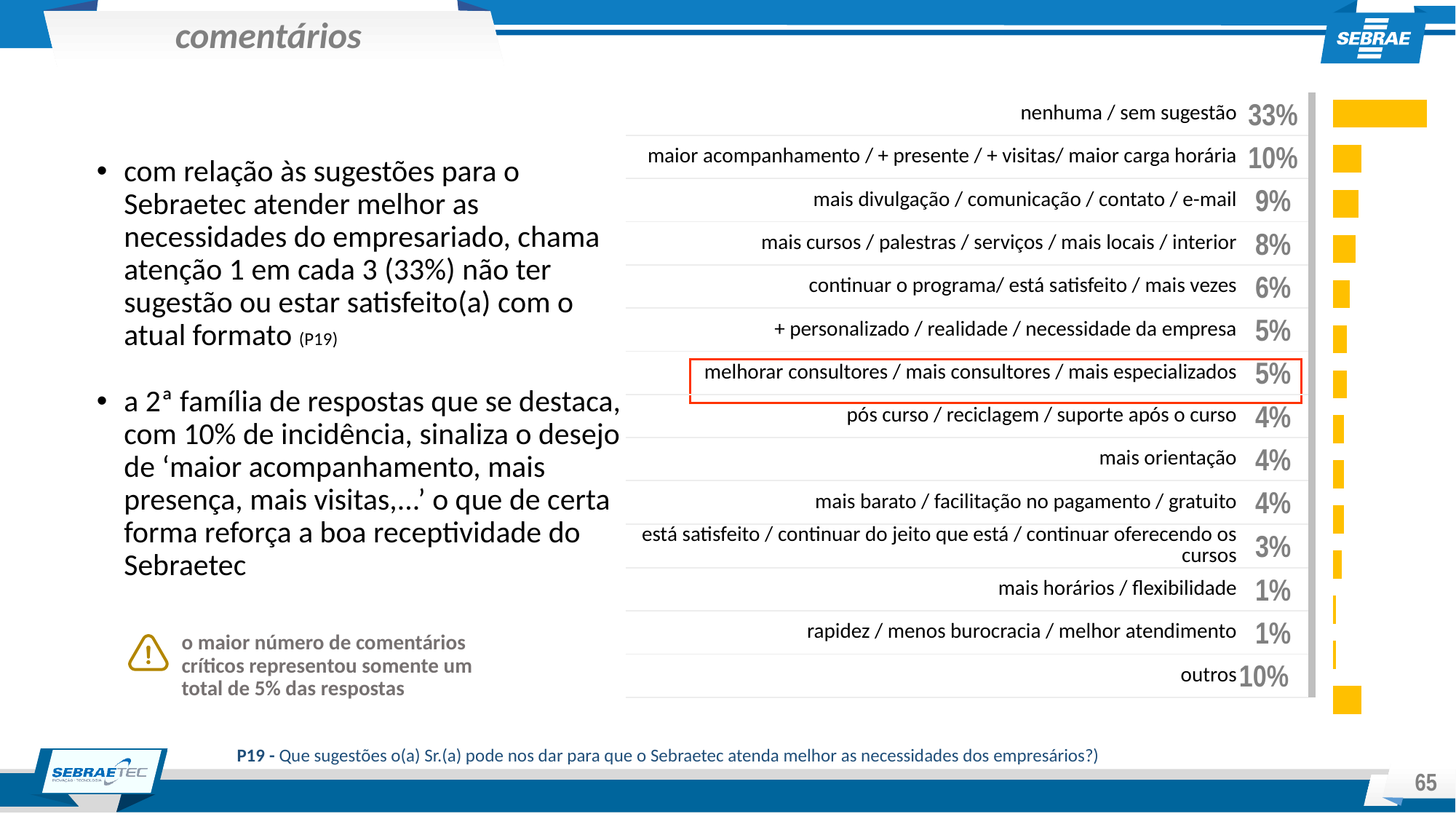
What value is shown for "mais divulgação / comunicação / contato / e-mail"? 9% What value is shown for "melhorar consultores / mais consultores / mais especializados"? 5% Which category has the highest value in the chart? nenhuma / sem sugestão How many categories are shown in the chart? 14 What type of chart is shown on the slide? Bar chart What is the difference between the values for "nenhuma / sem sugestão" and "maior acompanhamento / + presente / + visitas/ maior carga horária"? 23 percentage points What percentage of responses is shown for "nenhuma / sem sugestão"? 33% What value is shown for "outros"? 10% What is the difference between the values for "mais cursos / palestras / serviços / mais locais / interior" and "continuar o programa/ está satisfeito / mais vezes"? 2 percentage points Which has a larger value: "está satisfeito / continuar do jeito que está / continuar oferecendo os cursos" or "outros"? outros What value is shown for "mais horários / flexibilidade"? 1% Which has a larger value: "mais divulgação / comunicação / contato / e-mail" or "pós curso / reciclagem / suporte após o curso"? mais divulgação / comunicação / contato / e-mail